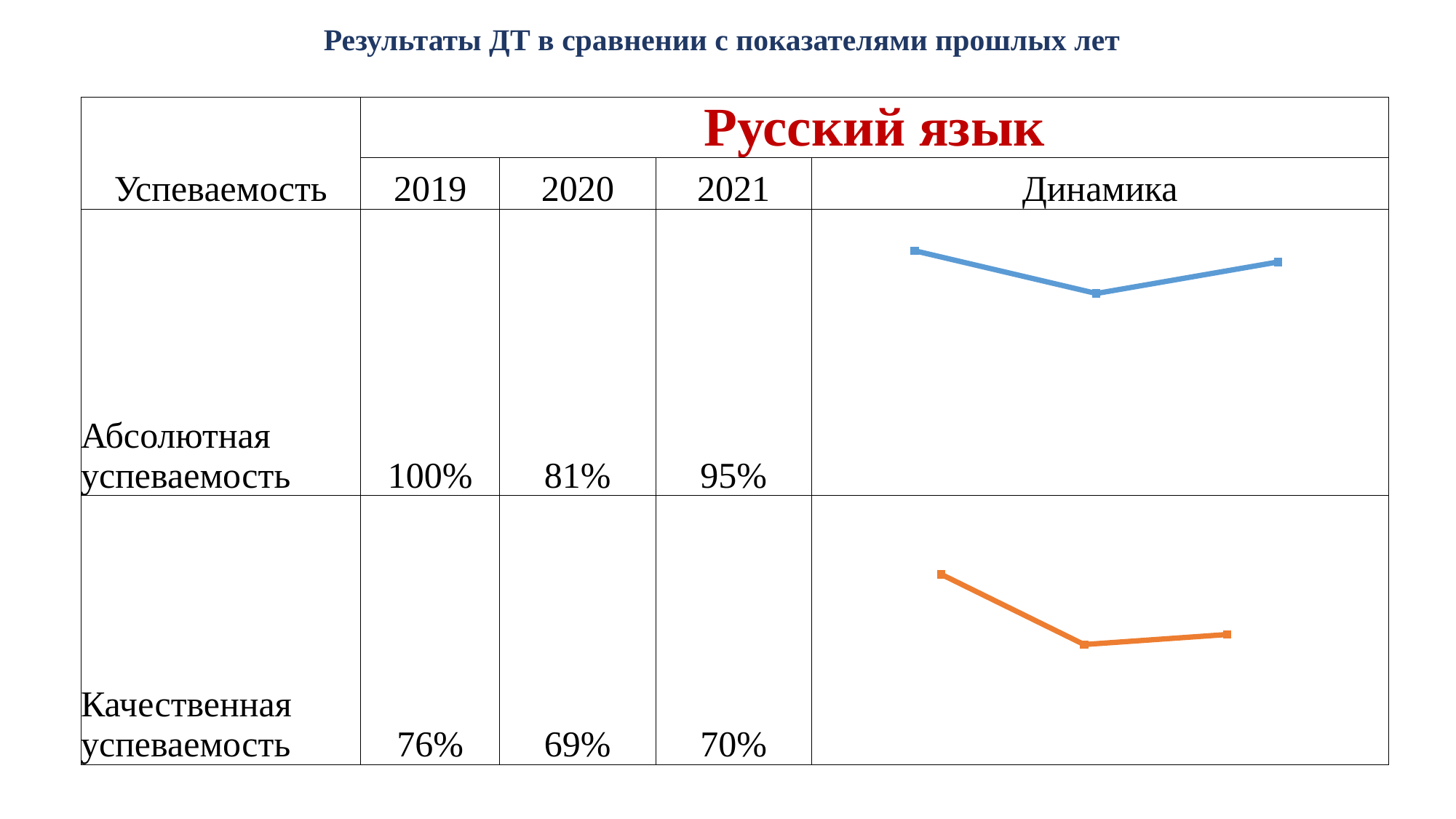
In the Качественная успеваемость row, what is the difference between the 2019 and 2021 values? 6% In the Абсолютная успеваемость row, what is the value for 2019? 100% How many data points does the line chart in the Качественная успеваемость row have? 3 In the Абсолютная успеваемость line chart, does the line rise or fall from 2020 to 2021? rise In the Абсолютная успеваемость row, which year has the lowest value? 2020 In the Качественная успеваемость row, which year has the highest value? 2019 In the Абсолютная успеваемость row, what is the value for 2020? 81% What colour is the line in the Качественная успеваемость row's chart? orange How many data points does the line chart in the Абсолютная успеваемость row have? 3 In the Качественная успеваемость row, what is the value for 2021? 70% What kind of chart is shown in the Динамика column for the Абсолютная успеваемость row? line chart In the Абсолютная успеваемость row, what is the difference between the 2019 and 2020 values? 19%